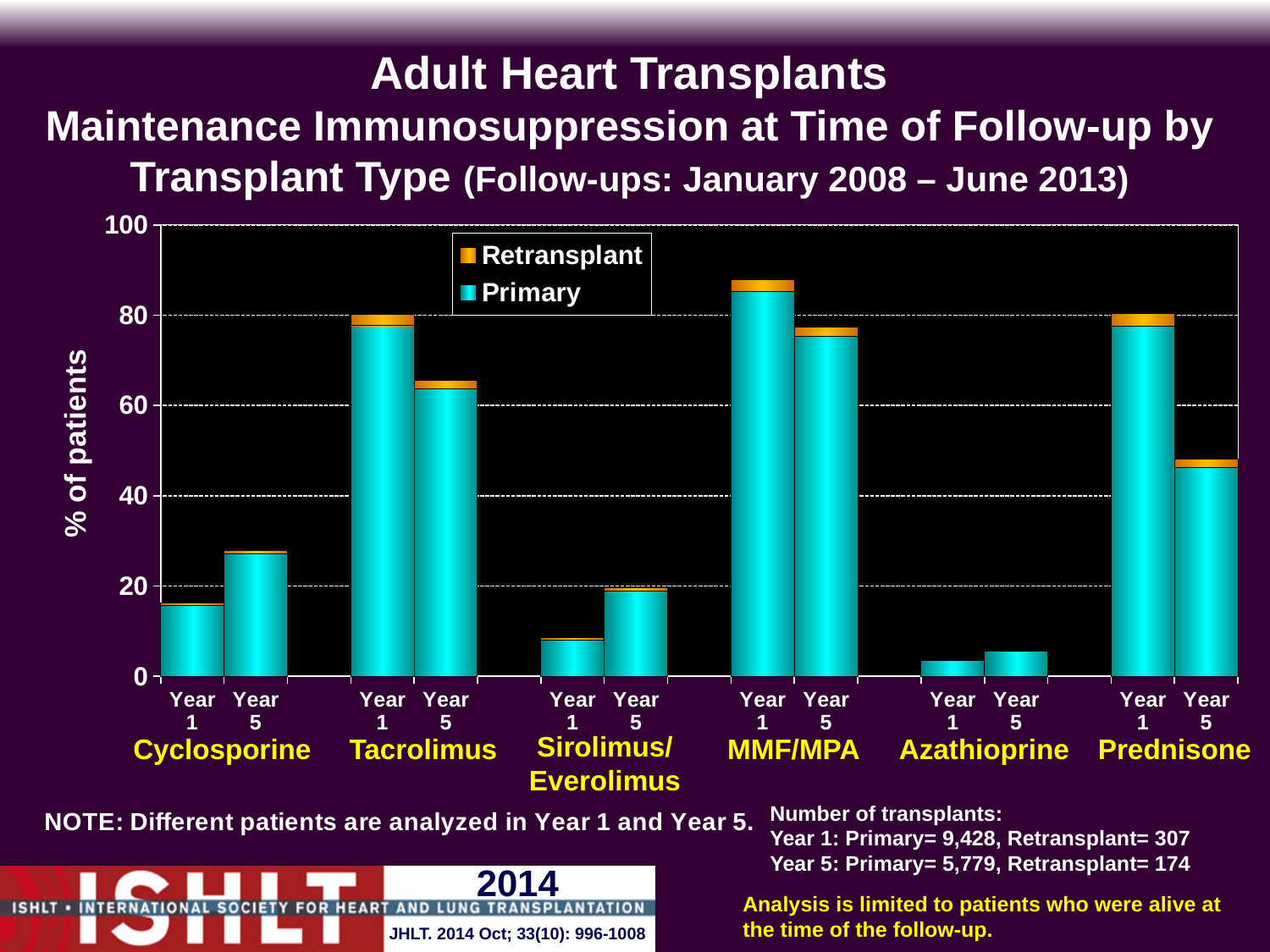
How many drug groups are shown along the x axis? 6 Is the value for MMF/MPA at Year 1 greater or less than 80? greater Which drug group has the highest Year 1 value? MMF/MPA What kind of chart is shown on the slide? bar chart For Cyclosporine, does the value rise or fall from Year 1 to Year 5? rise Is the value for Cyclosporine at Year 5 greater or less than 40? less Is the value for Prednisone at Year 5 greater or less than 60? less For Tacrolimus, which is larger: the Year 1 value or the Year 5 value? Year 1 What are the two series named in the legend? Retransplant and Primary Which drug group has the lowest Year 1 value? Azathioprine How many series does the legend list? 2